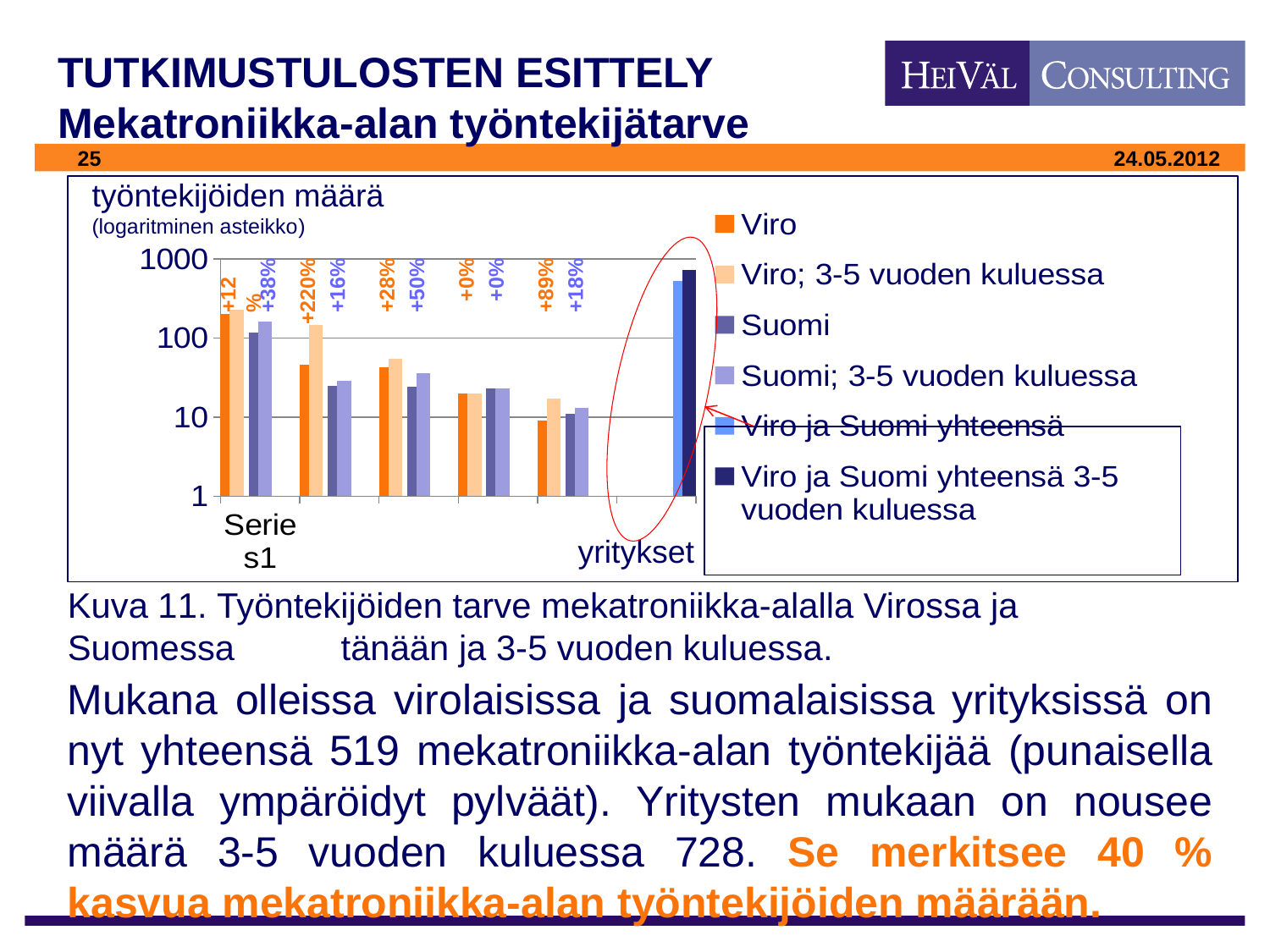
Which legend entry is shown in orange? Viro How many percentage change labels are printed above the bars? 10 What is the lowest percentage change label printed above the bars? +0% What is the highest tick value shown on the vertical axis? 1000 In the 'yritykset' group, which bar is taller: 'Viro ja Suomi yhteensä' or 'Viro ja Suomi yhteensä 3-5 vuoden kuluessa'? Viro ja Suomi yhteensä 3-5 vuoden kuluessa How many series does the chart legend list? 6 Is the value of the 'Viro ja Suomi yhteensä' bar in the 'yritykset' group greater or less than 100? greater Is the value of the 'Viro' bar in the first category group greater or less than 100? greater What is the title of the chart's vertical axis? työntekijöiden määrä (logaritminen asteikko) What is the highest percentage change label printed above the bars? +220% What kind of chart is shown on the slide? bar chart